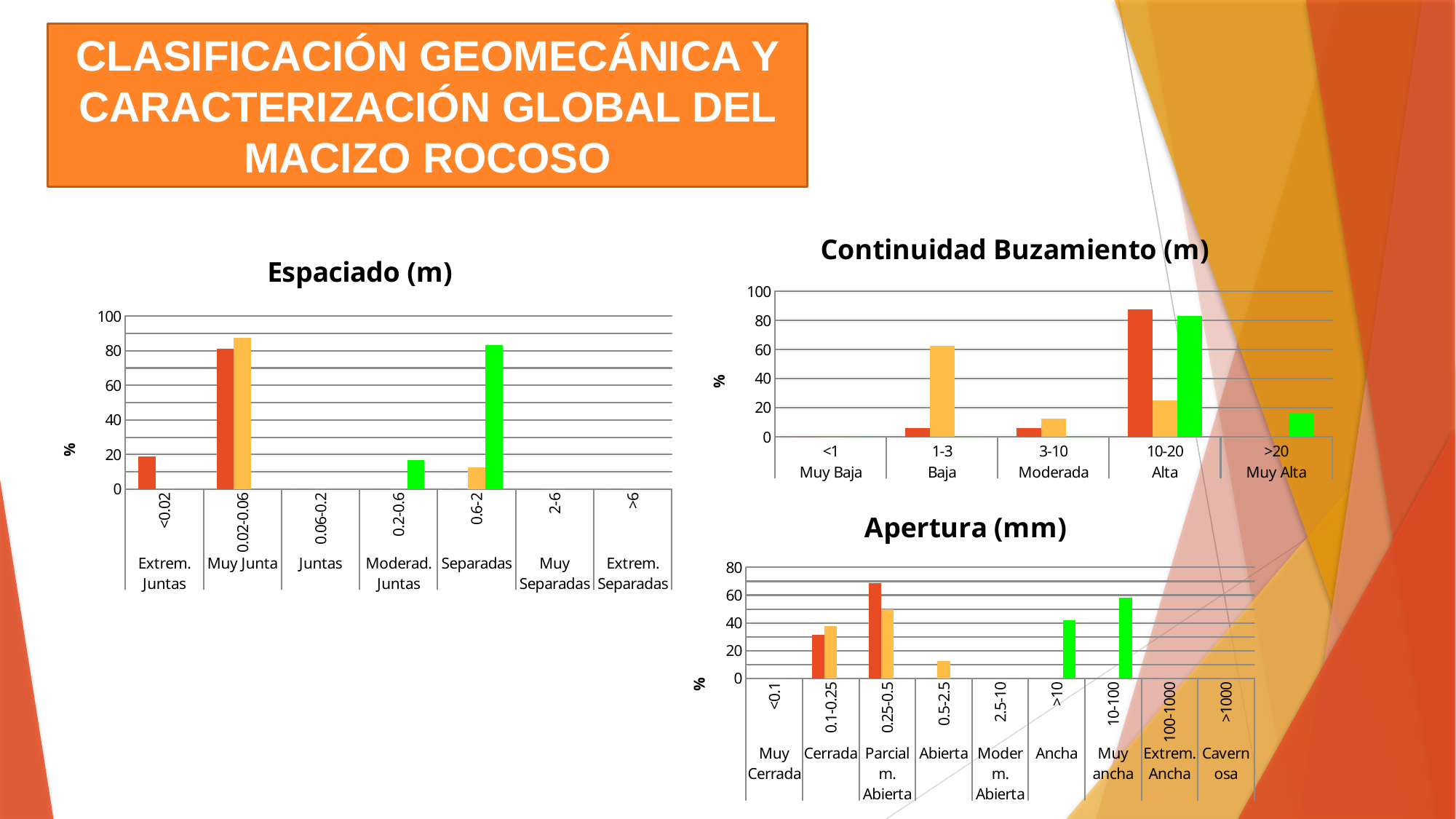
In the 'Espaciado (m)' chart, is the green bar for 'Separadas' greater or less than 60? greater What is the title of the chart in the top right of the slide? Continuidad Buzamiento (m) In the 'Continuidad Buzamiento (m)' chart, how many categories are shown on the x axis? 5 In the 'Apertura (mm)' chart, which category has the tallest bar? Parcialm. Abierta In the 'Espaciado (m)' chart, is the green bar for 'Moderad. Juntas' greater or less than 40? less In the 'Apertura (mm)' chart, is the red bar for 'Parcialm. Abierta' greater or less than 60? greater In the 'Espaciado (m)' chart, how many categories are shown on the x axis? 7 In the 'Continuidad Buzamiento (m)' chart, for the '10-20 Alta' category, which is larger: the red bar or the orange bar? the red bar What kind of chart is the 'Espaciado (m)' chart? bar chart In the 'Apertura (mm)' chart, which green bar is taller: 'Ancha' or 'Muy ancha'? Muy ancha In the 'Apertura (mm)' chart, how many categories are shown on the x axis? 9